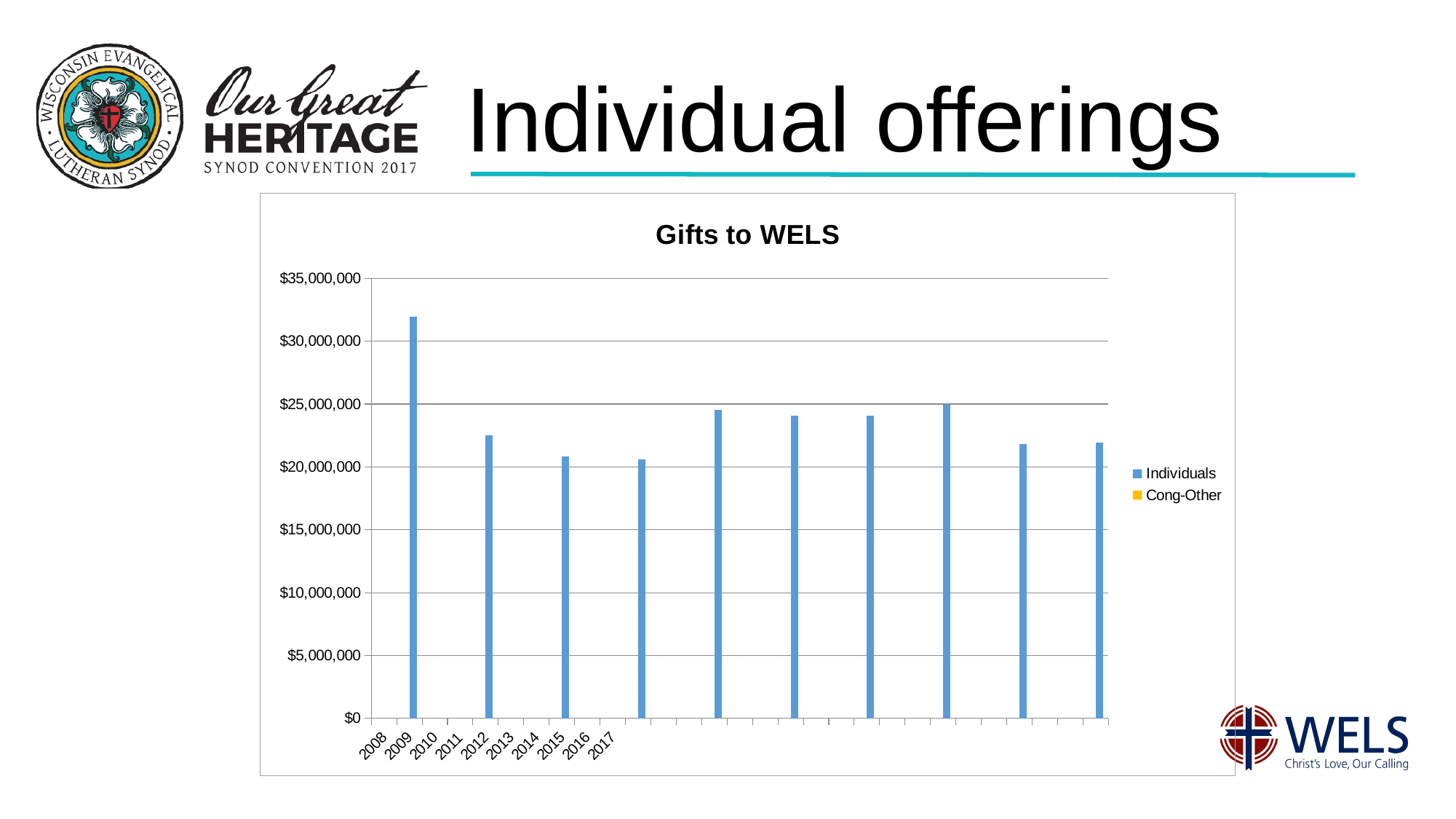
What is the title of the chart? Gifts to WELS How many bars are plotted in the chart? 10 Is the value of the first (leftmost) bar greater or less than $30,000,000? greater Which bar is the highest in the chart? The first (leftmost) bar How many series does the legend list? 2 Do the values rise or fall from the first bar to the fourth bar? fall Is the value of the second bar greater or less than $25,000,000? less What kind of chart is shown on the slide? Bar chart What are the two series named in the legend? Individuals and Cong-Other Which is larger, the first bar or the second bar? The first bar Is the value of the last (rightmost) bar greater or less than $25,000,000? less